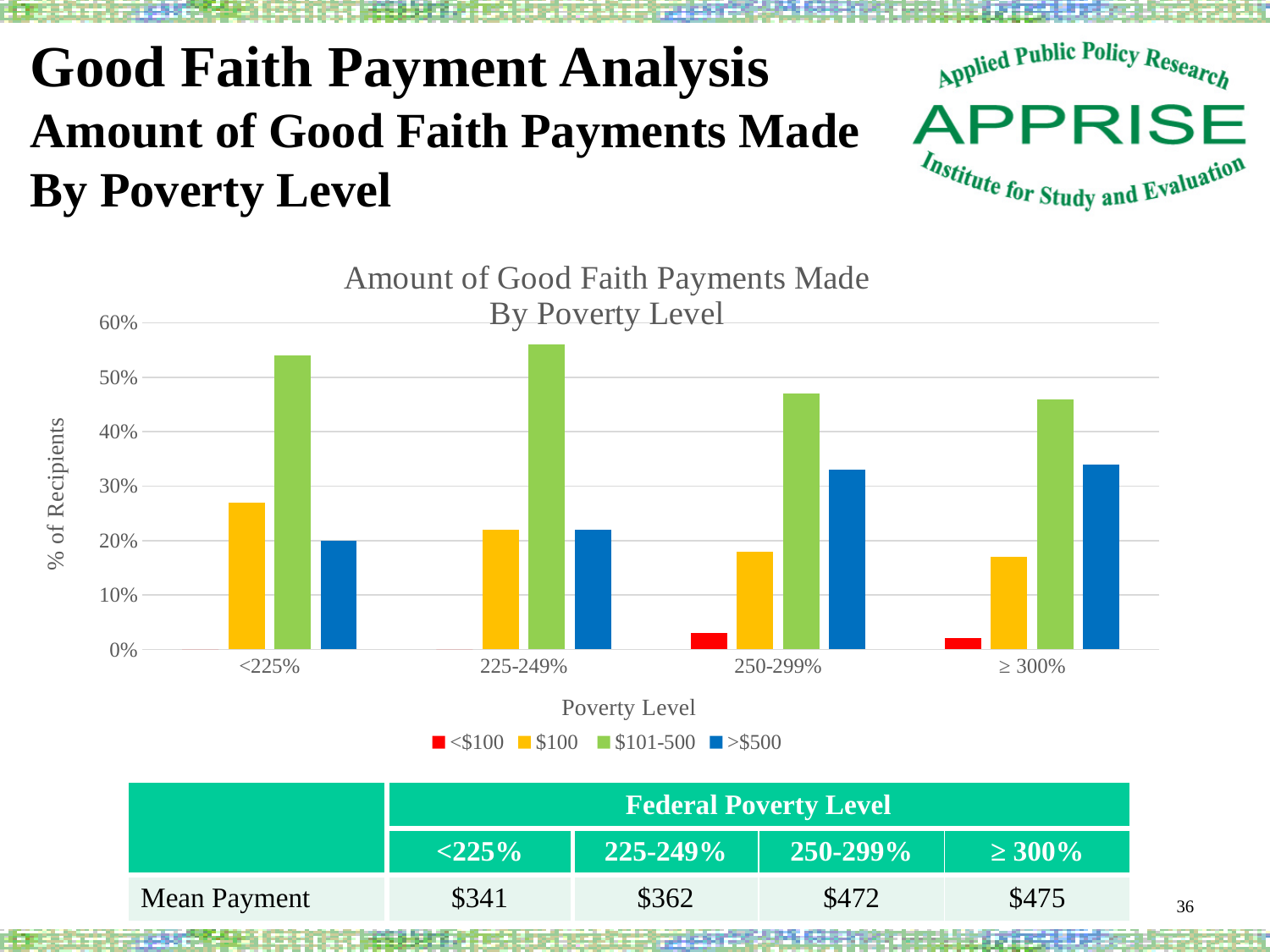
Is the value for $100 at the 225-249% poverty level greater or less than 30%? less Which payment amount series has the tallest bar in every poverty level category? $101-500 What colour represents the <$100 series in the legend? red Is the value for >$500 at the 250-299% poverty level greater or less than 30%? greater How many poverty level categories are shown on the x axis? 4 How many series does the chart legend list? 4 What kind of chart is shown on the slide? bar chart Which poverty level has the highest bar for the $100 series? <225% Is the value for <$100 at the 250-299% poverty level greater or less than 10%? less Do the values for the $100 series rise or fall as poverty level increases along the x axis? fall At the <225% poverty level, which is larger: the $100 bar or the >$500 bar? $100